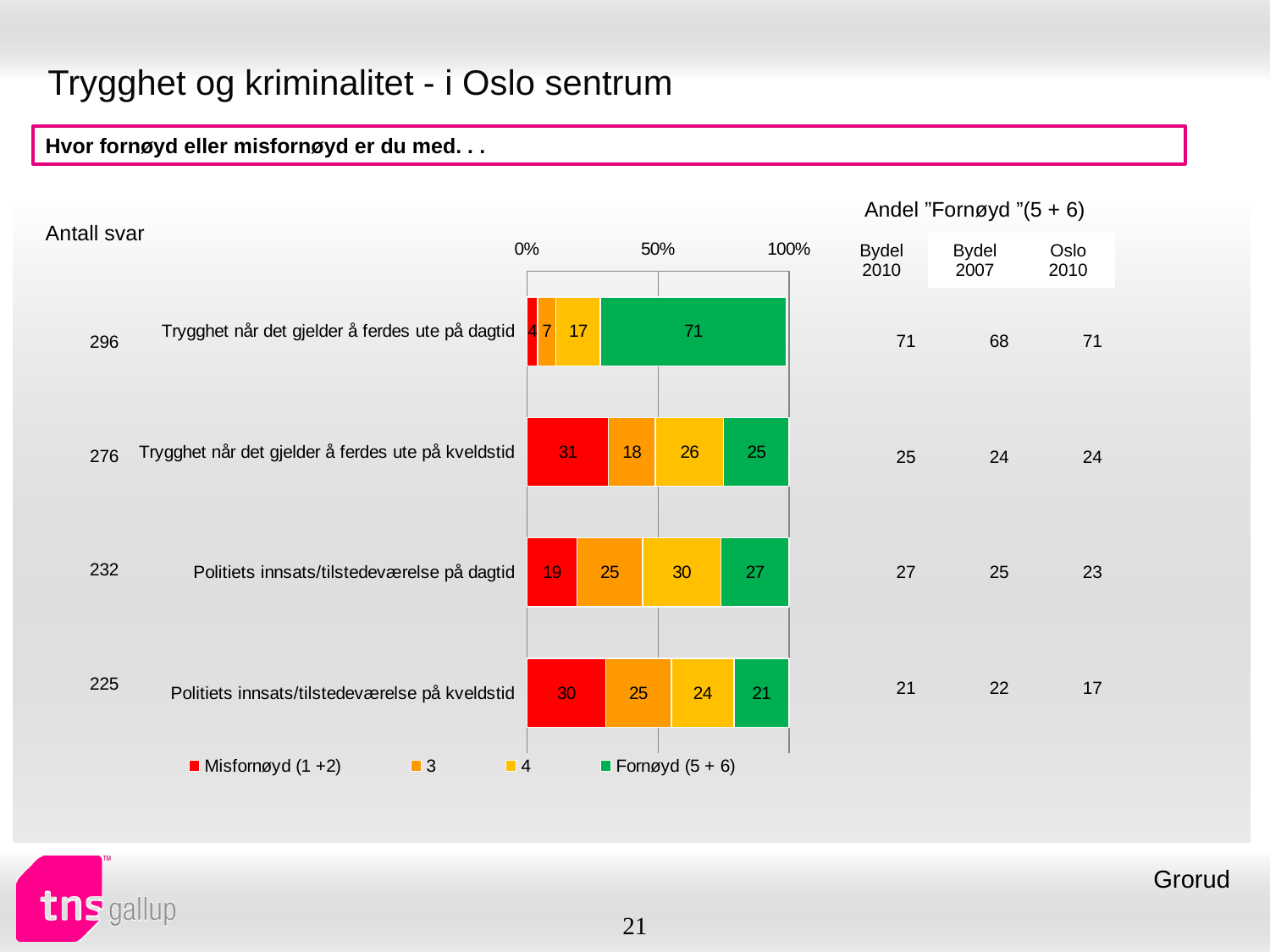
What kind of chart is shown on the slide? Stacked bar chart How many series does the legend list? 4 Which category has the lowest "Misfornøyd (1 +2)" value? Trygghet når det gjelder å ferdes ute på dagtid What is the difference between the "Fornøyd (5 + 6)" values for "Trygghet når det gjelder å ferdes ute på dagtid" and "Trygghet når det gjelder å ferdes ute på kveldstid"? 46 Which is larger: the "Misfornøyd (1 +2)" value for "Politiets innsats/tilstedeværelse på dagtid" or for "Politiets innsats/tilstedeværelse på kveldstid"? Politiets innsats/tilstedeværelse på kveldstid What is the value of "Fornøyd (5 + 6)" for "Trygghet når det gjelder å ferdes ute på dagtid"? 71 How many categories are shown in the chart? 4 What is the value of series "4" for "Politiets innsats/tilstedeværelse på dagtid"? 30 Which category has the highest "Fornøyd (5 + 6)" value? Trygghet når det gjelder å ferdes ute på dagtid What is the value of series "3" for "Politiets innsats/tilstedeværelse på kveldstid"? 25 What is the total of the stacked bar for "Politiets innsats/tilstedeværelse på kveldstid"? 100 What is the value of "Misfornøyd (1 +2)" for "Trygghet når det gjelder å ferdes ute på kveldstid"? 31